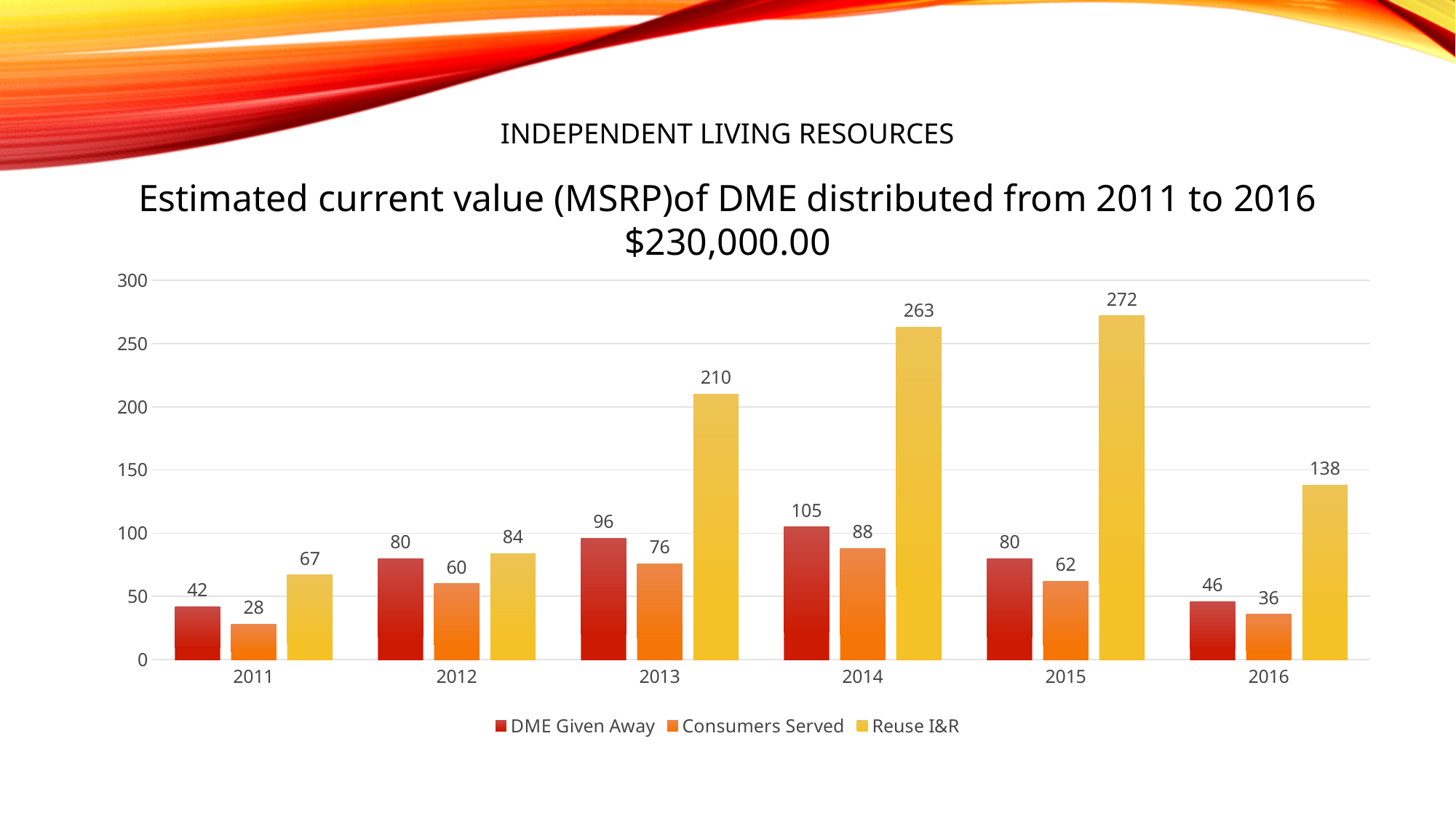
What is the value for Consumers Served in 2011? 28 What is the total of the three values for 2012? 224 What is the value for DME Given Away in 2013? 96 How many years are shown on the x axis? 6 Is the value for Reuse I&R in 2013 greater or less than 200? greater How many series does the legend list? 3 What is the value for Reuse I&R in 2014? 263 In which year is the Reuse I&R value highest? 2015 Which is larger in 2014: DME Given Away or Consumers Served? DME Given Away What kind of chart is shown on the slide? Bar chart What is the difference between the Reuse I&R values for 2015 and 2016? 134 In which year is the Consumers Served value lowest? 2011